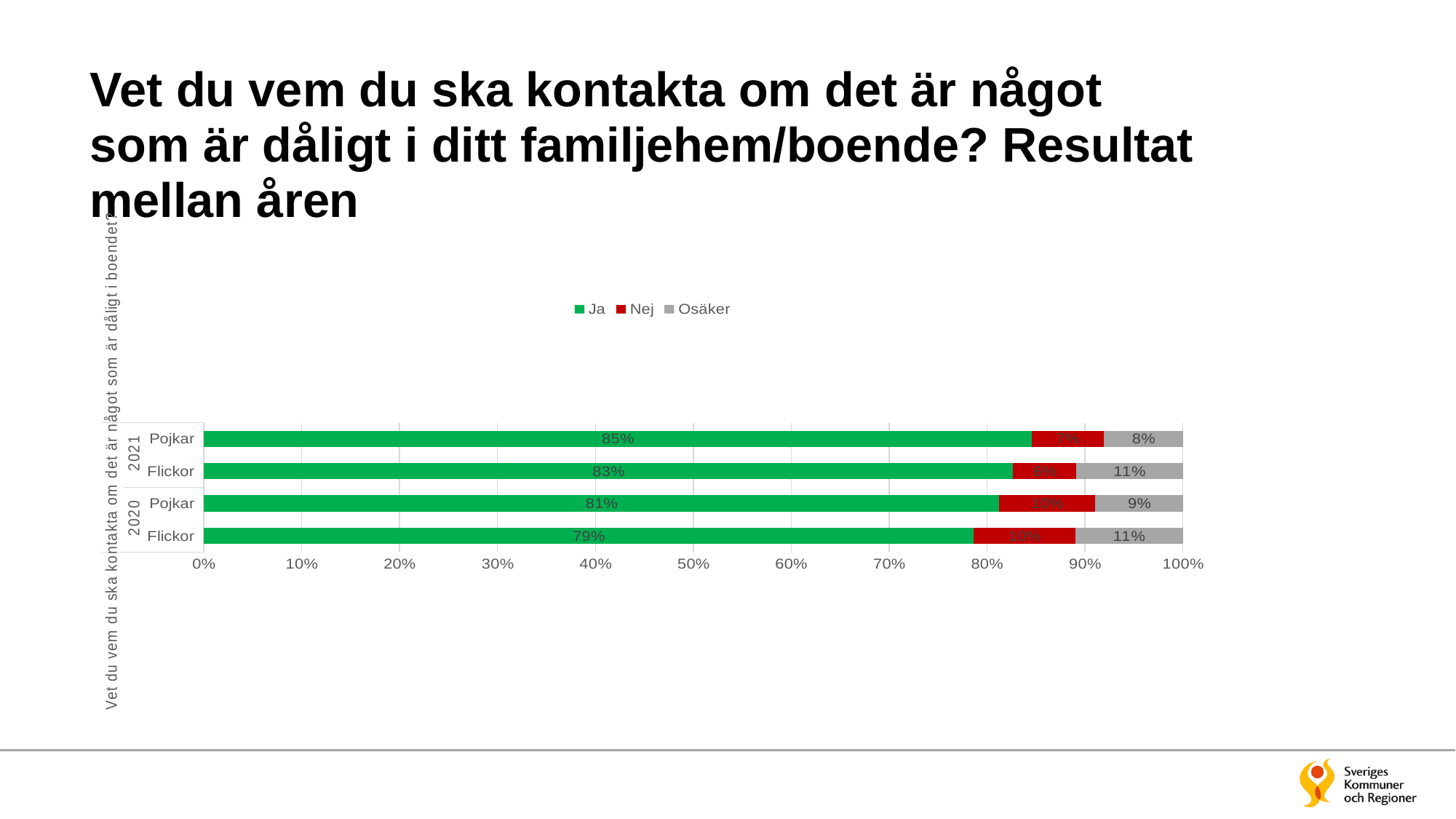
Which group has the highest Ja share? Pojkar 2021 Which group has the lowest Ja share? Flickor 2020 What is the Ja value for Flickor in 2020? 79% How many bars (groups) are plotted in the chart? 4 Which has a larger Ja value: Pojkar 2020 or Flickor 2021? Flickor 2021 What is the Osäker value for Flickor in 2021? 11% What is the Ja value for Pojkar in 2021? 85% What kind of chart is shown on the slide? Stacked bar chart What is the Osäker value for Pojkar in 2020? 9% What is the difference between the Ja value for Pojkar 2021 and the Ja value for Flickor 2020? 6 percentage points What are the legend entries of the chart? Ja, Nej, Osäker How many series does the legend list? 3